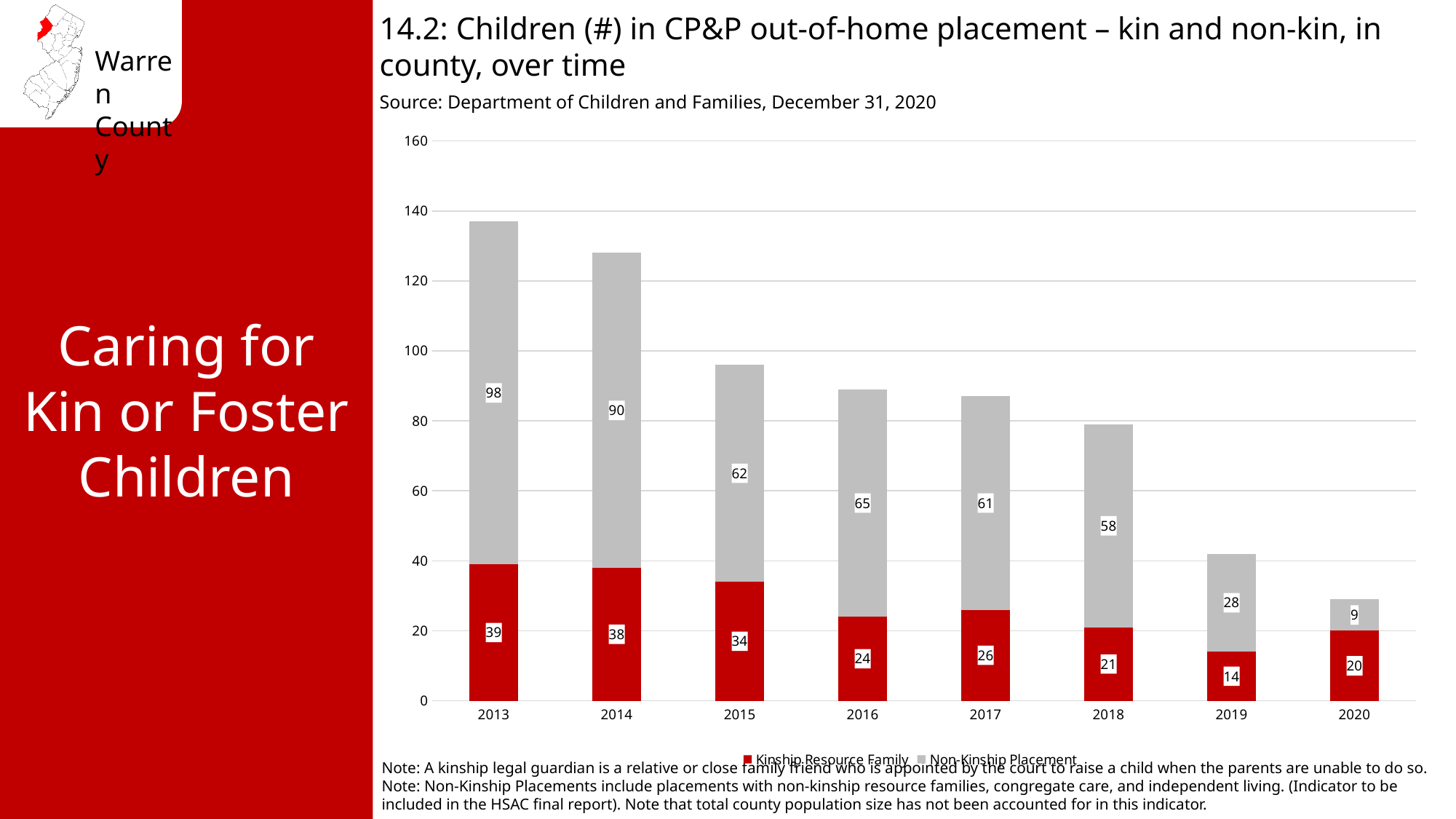
What is the difference between the Non-Kinship Placement values for 2014 and 2015? 28 What is the Non-Kinship Placement value for 2020? 9 Does the total height of the stacked bars generally rise or fall from 2013 to 2020? Fall Which is larger in 2020: the Kinship Resource Family value or the Non-Kinship Placement value? Kinship Resource Family Which year has the highest Non-Kinship Placement value? 2013 Which year has the lowest Kinship Resource Family value? 2019 How many years are shown on the x axis of the chart? 8 What type of chart is shown on the slide? Stacked bar chart How many series does the chart's legend list? 2 What is the Kinship Resource Family value for 2013? 39 What is the Non-Kinship Placement value for 2016? 65 What is the total number of children in out-of-home placement in 2019 (both series combined)? 42